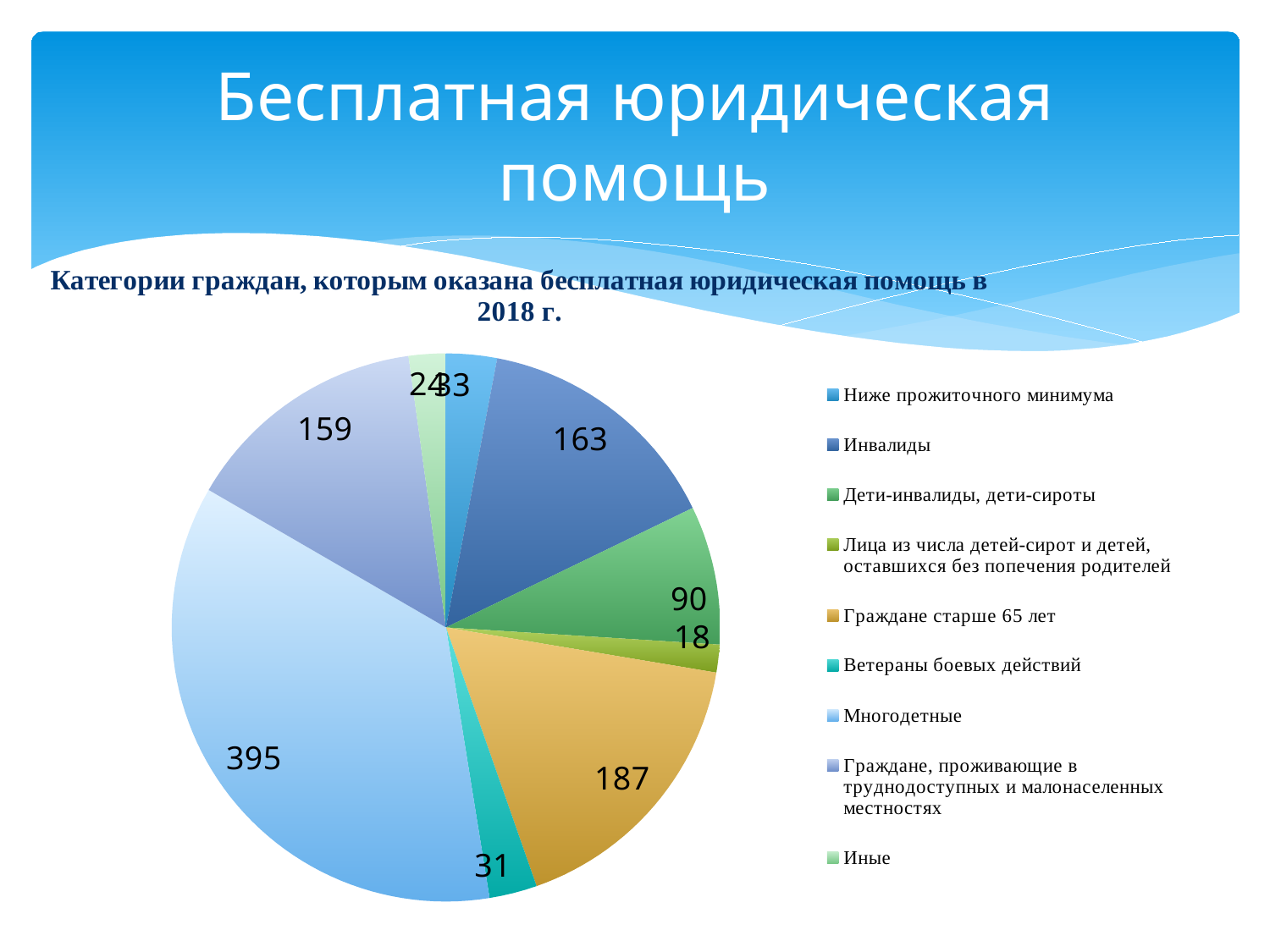
Which category has the largest slice of the pie? Многодетные Which is larger, the value for Инвалиды or the value for Дети-инвалиды, дети-сироты? Инвалиды Which category has the smallest slice of the pie? Лица из числа детей-сирот и детей, оставшихся без попечения родителей How many categories does the legend list? 9 What is the value for Граждане, проживающие в труднодоступных и малонаселенных местностях? 159 What is the value for Дети-инвалиды, дети-сироты? 90 What is the difference between the values for Многодетные and Граждане старше 65 лет? 208 What is the value for Граждане старше 65 лет? 187 What is the value for Инвалиды? 163 What is the value for Ветераны боевых действий? 31 What type of chart is shown on the slide? pie chart What is the value for Многодетные? 395